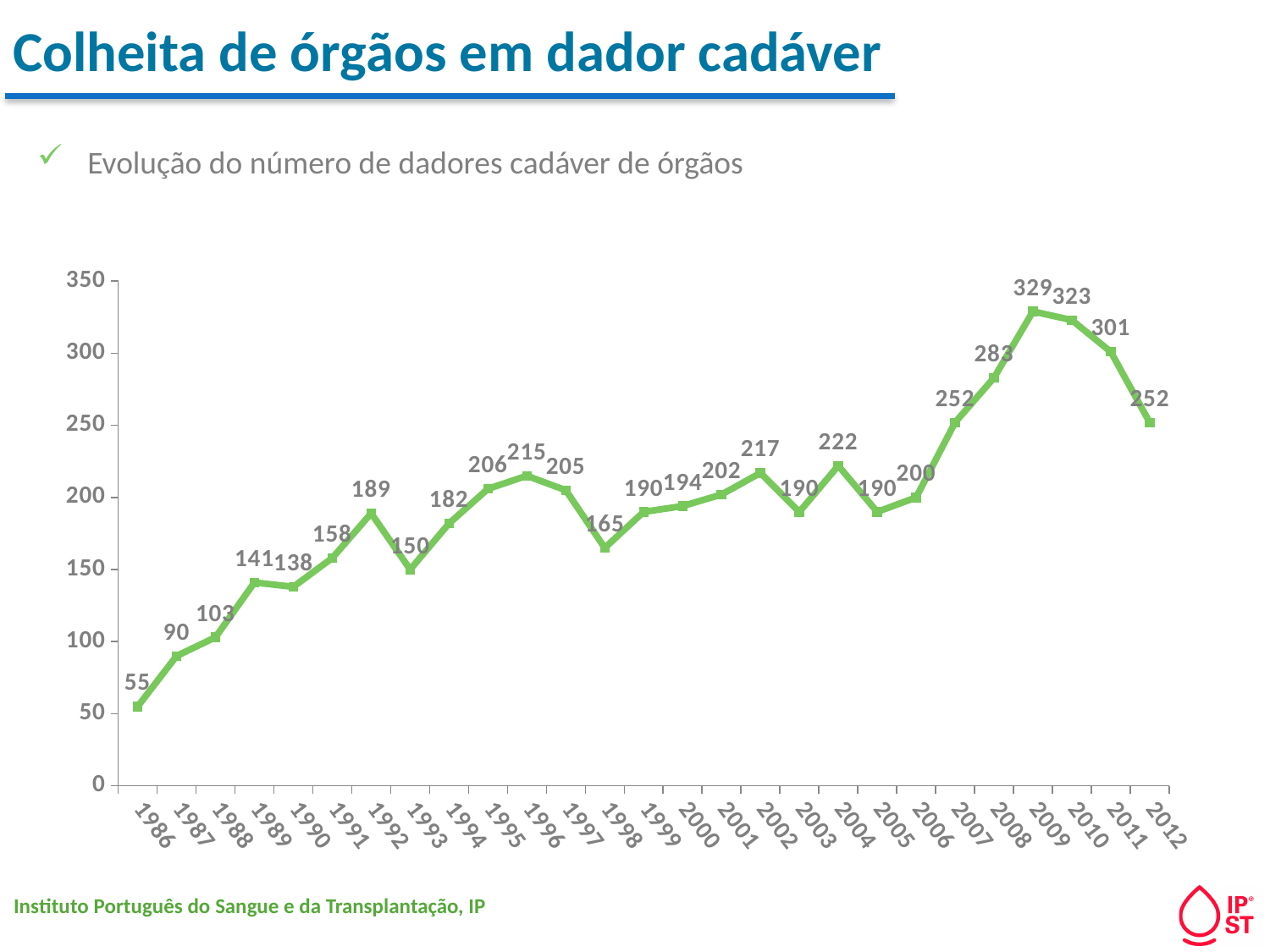
Do the values rise or fall from 2009 to 2012? fall Which year has the lowest value? 1986 What is the value for 2004? 222 What is the value for 1986? 55 What is the value for 2009? 329 What is the difference between the values for 2009 and 2012? 77 What is the difference between the values for 1992 and 1993? 39 Which is larger, the value for 1996 or the value for 2002? 2002 Is the value for 2008 greater or less than 250? greater How many years are plotted on the x axis? 27 What kind of chart is shown? line chart Which year has the highest value? 2009